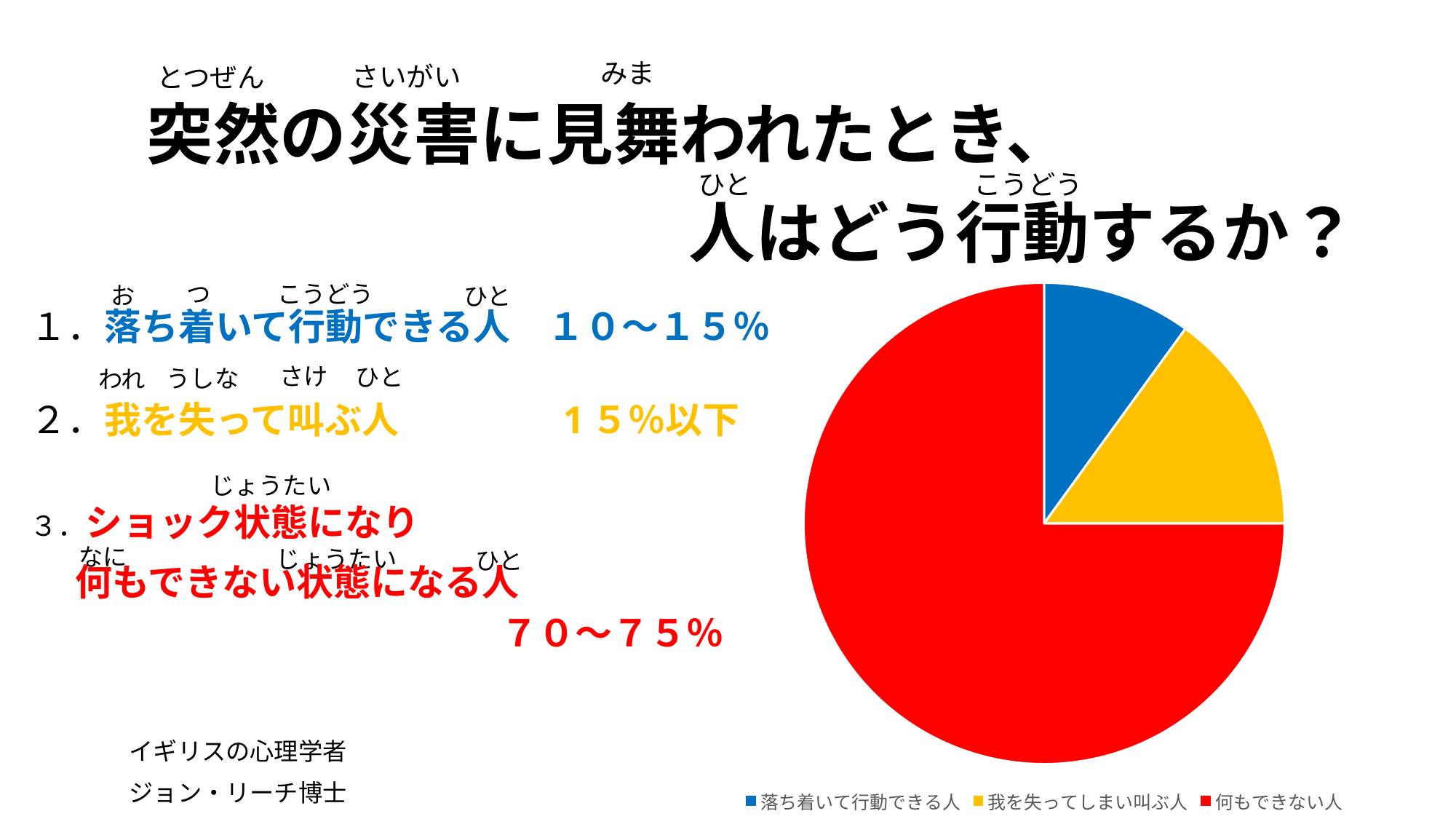
What colour is the slice for 何もできない人 in the pie chart? Red Which category has the largest slice in the pie chart? 何もできない人 Which slice is larger in the pie chart, 何もできない人 or 落ち着いて行動できる人? 何もできない人 Which legend entry is shown in blue in the pie chart? 落ち着いて行動できる人 How many entries does the legend of the pie chart list? 3 How many slices does the pie chart have? 3 What kind of chart is shown on the slide? Pie chart Which slice is larger in the pie chart, 我を失ってしまい叫ぶ人 or 何もできない人? 何もできない人